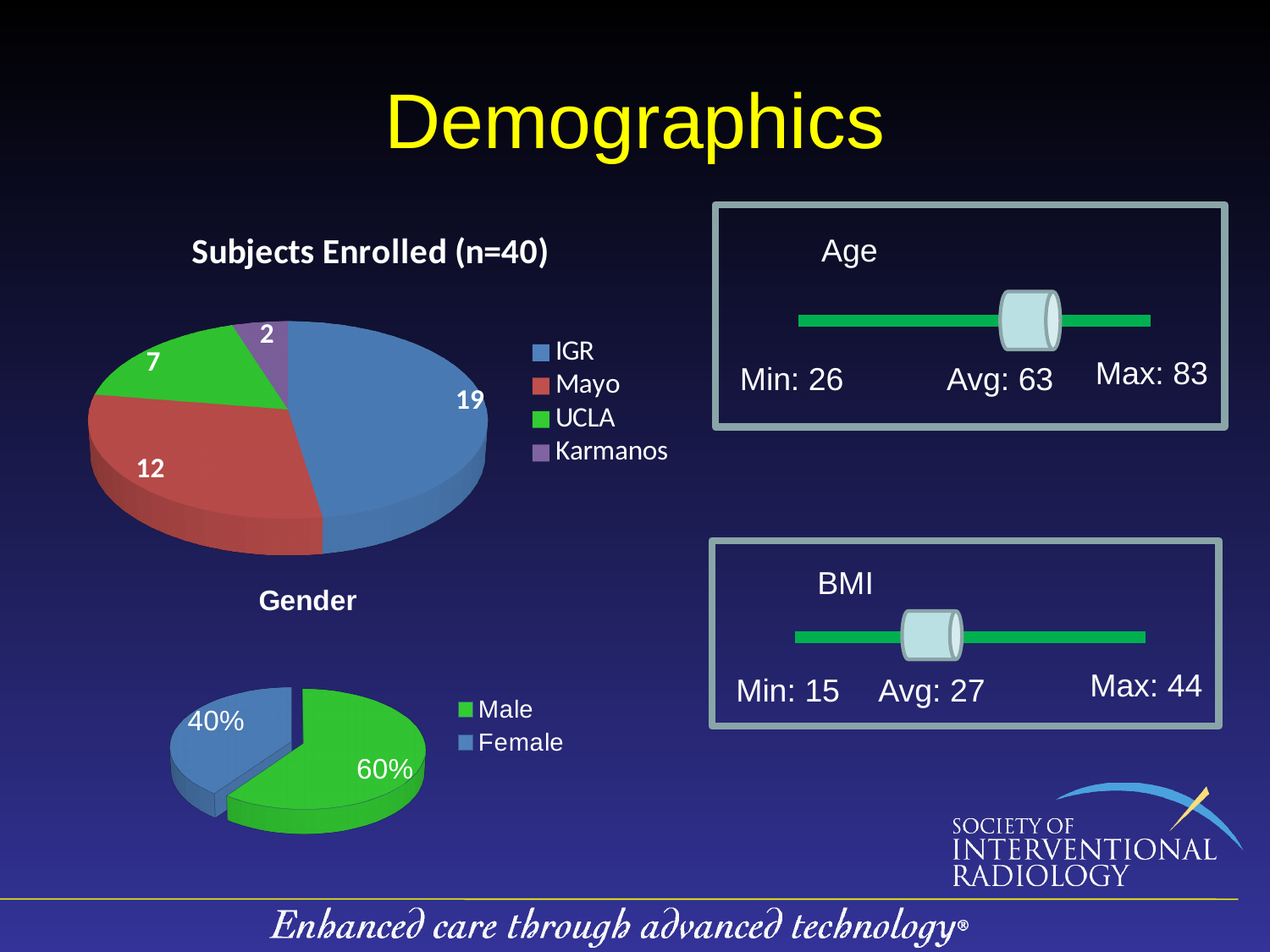
In the Subjects Enrolled (n=40) pie chart, what share of the 40 subjects were enrolled at IGR? 47.5% How many sites are shown in the Subjects Enrolled (n=40) pie chart? 4 In the Gender pie chart, what percentage of subjects are Male? 60% In the Subjects Enrolled (n=40) pie chart, which site enrolled more subjects, UCLA or Karmanos? UCLA In the Subjects Enrolled (n=40) pie chart, which site enrolled the fewest subjects? Karmanos In the Subjects Enrolled (n=40) pie chart, which site enrolled the most subjects? IGR In the Subjects Enrolled (n=40) pie chart, how many subjects were enrolled at Mayo? 12 In the Subjects Enrolled (n=40) pie chart, how many subjects were enrolled at IGR? 19 In the Subjects Enrolled (n=40) pie chart, what is the difference between the number of subjects enrolled at IGR and at Mayo? 7 In the Subjects Enrolled (n=40) pie chart, which colour represents Mayo? Red What type of chart is the Gender chart? Pie chart In the Gender pie chart, what percentage of subjects are Female? 40%